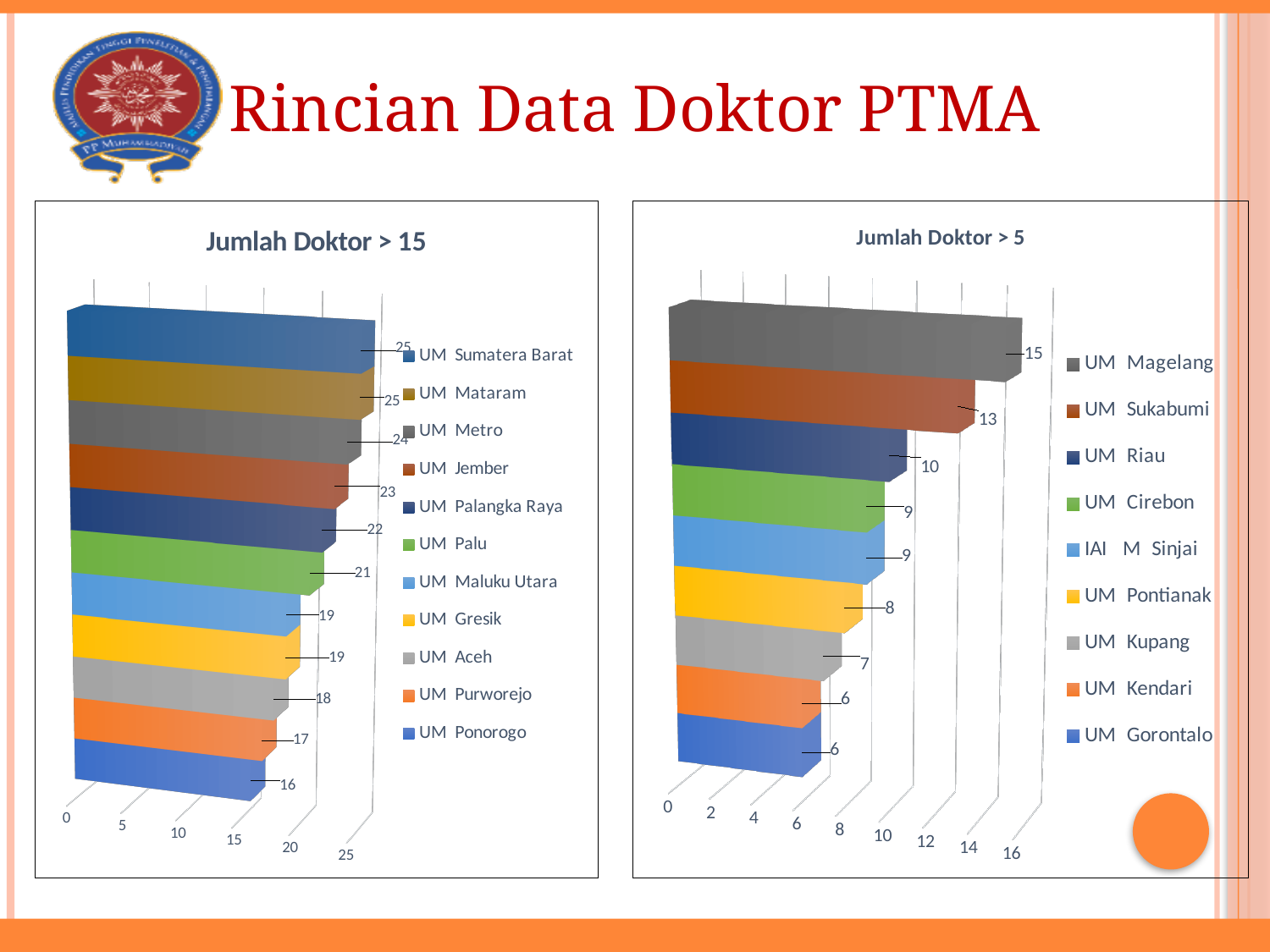
In the chart titled "Jumlah Doktor > 15", what is the value for UM Palu? 21 In the chart titled "Jumlah Doktor > 5", which category has the highest value? UM Magelang In the chart titled "Jumlah Doktor > 5", what is the value for UM Kupang? 7 In the chart titled "Jumlah Doktor > 5", what is the value for UM Sukabumi? 13 What kind of chart is the chart titled "Jumlah Doktor > 5"? Bar chart In the chart titled "Jumlah Doktor > 15", what is the value for UM Metro? 24 In the chart titled "Jumlah Doktor > 5", how many categories are shown? 9 In the chart titled "Jumlah Doktor > 5", what is the difference between the values for UM Magelang and UM Riau? 5 In the chart titled "Jumlah Doktor > 15", what is the difference between the values for UM Jember and UM Aceh? 5 In the chart titled "Jumlah Doktor > 15", which is larger, the value for UM Palangka Raya or the value for UM Purworejo? UM Palangka Raya In the chart titled "Jumlah Doktor > 15", which category has the lowest value? UM Ponorogo In the chart titled "Jumlah Doktor > 15", how many categories are shown? 11